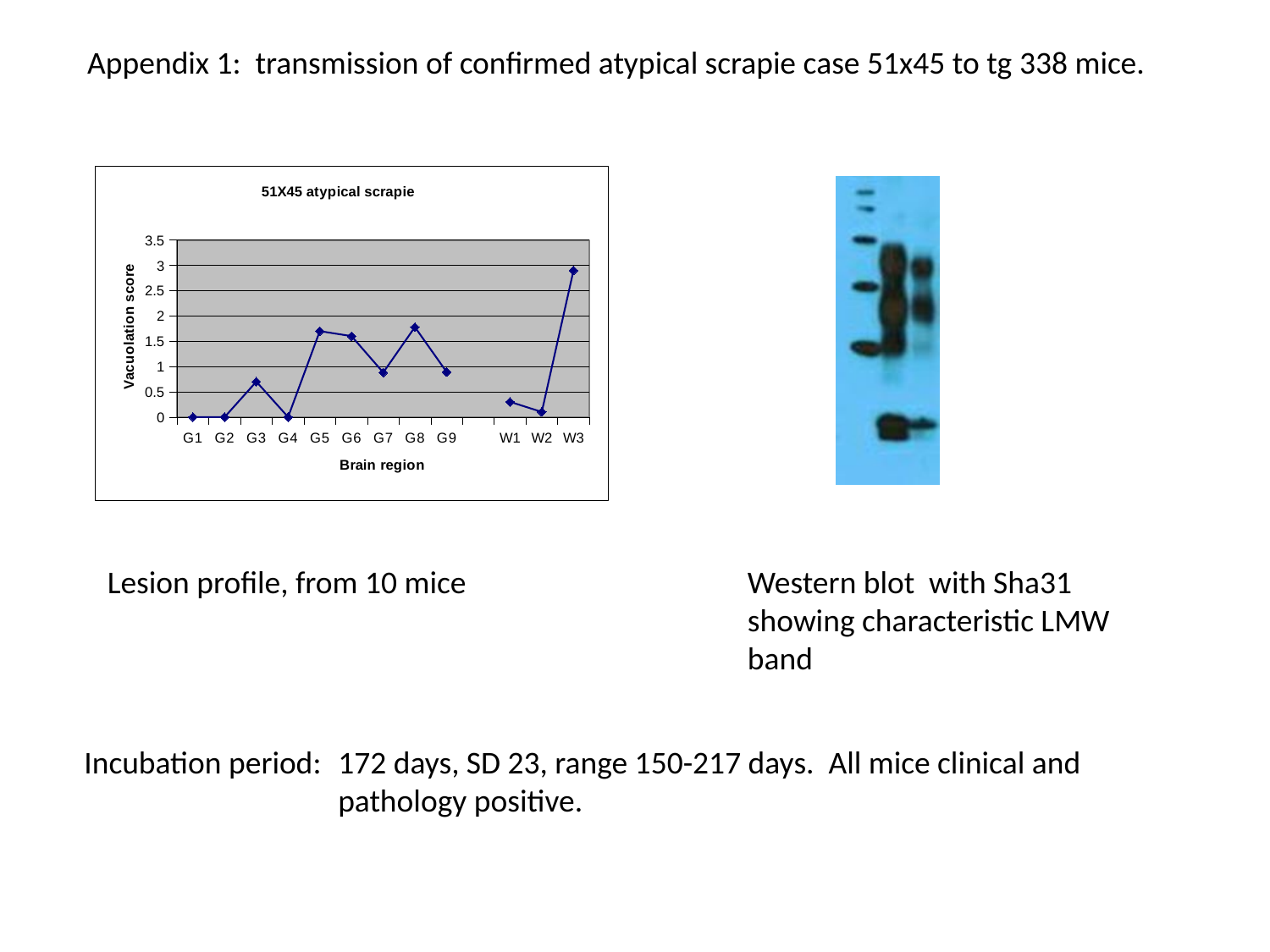
What is the label of the y-axis of the chart? Vacuolation score Is the vacuolation score for G8 greater or less than 1.5? greater Which has a higher vacuolation score, G5 or G7? G5 Which brain region has the highest vacuolation score? W3 Is the vacuolation score for W3 greater or less than 2.5? greater What type of chart is shown on the slide? Line chart Is the vacuolation score for G7 greater or less than 1? less What is the vacuolation score for G1? 0 How many brain regions are plotted on the x-axis of the chart? 12 What is the title of the chart? 51X45 atypical scrapie Which has a higher vacuolation score, W3 or W2? W3 What is the vacuolation score for G4? 0